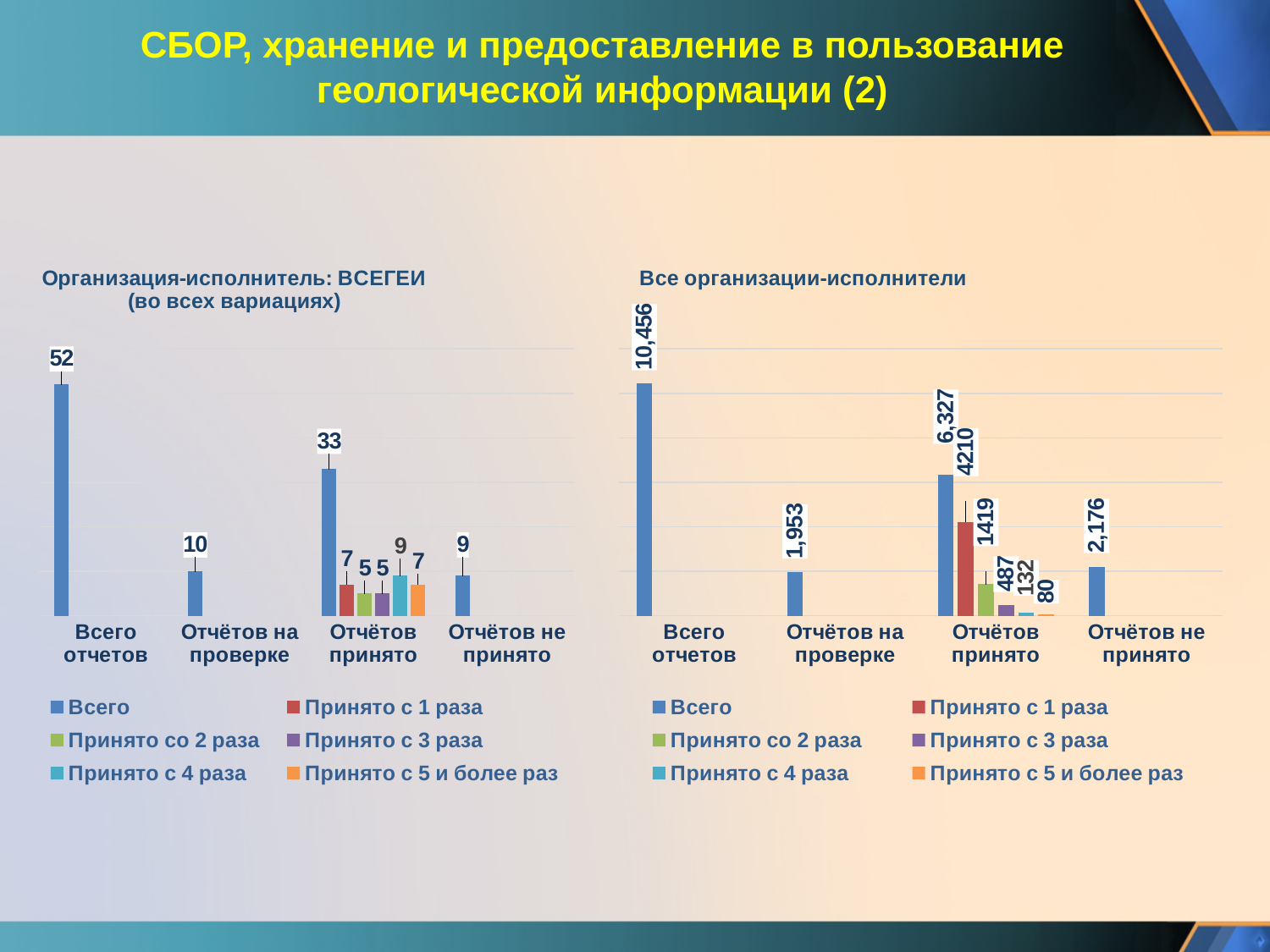
In the chart titled "Все организации-исполнители", which series has the lowest value within "Отчётов принято"? Принято с 5 и более раз In the chart titled "Все организации-исполнители", what is the difference between "Принято со 2 раза" and "Принято с 3 раза" for "Отчётов принято"? 932 In the chart titled "Все организации-исполнители", which is larger: "Отчётов на проверке" or "Отчётов не принято"? Отчётов не принято In the chart titled "Организация-исполнитель: ВСЕГЕИ (во всех вариациях)", what is the value of "Принято с 4 раза" for "Отчётов принято"? 9 In the chart titled "Все организации-исполнители", what is the value of "Принято с 1 раза" for "Отчётов принято"? 4210 How many series does the legend of the chart titled "Все организации-исполнители" list? 6 In the chart titled "Все организации-исполнители", what is the value for "Отчётов не принято"? 2,176 In the chart titled "Организация-исполнитель: ВСЕГЕИ (во всех вариациях)", what is the difference between the "Всего" values for "Всего отчетов" and "Отчётов принято"? 19 In the chart titled "Организация-исполнитель: ВСЕГЕИ (во всех вариациях)", what is the value for "Отчётов на проверке"? 10 In the chart titled "Организация-исполнитель: ВСЕГЕИ (во всех вариациях)", what is the value of the "Всего" series for "Всего отчетов"? 52 What kind of chart is the chart titled "Организация-исполнитель: ВСЕГЕИ (во всех вариациях)"? Bar chart In the chart titled "Все организации-исполнители", what is the value of the "Всего" series for "Всего отчетов"? 10,456